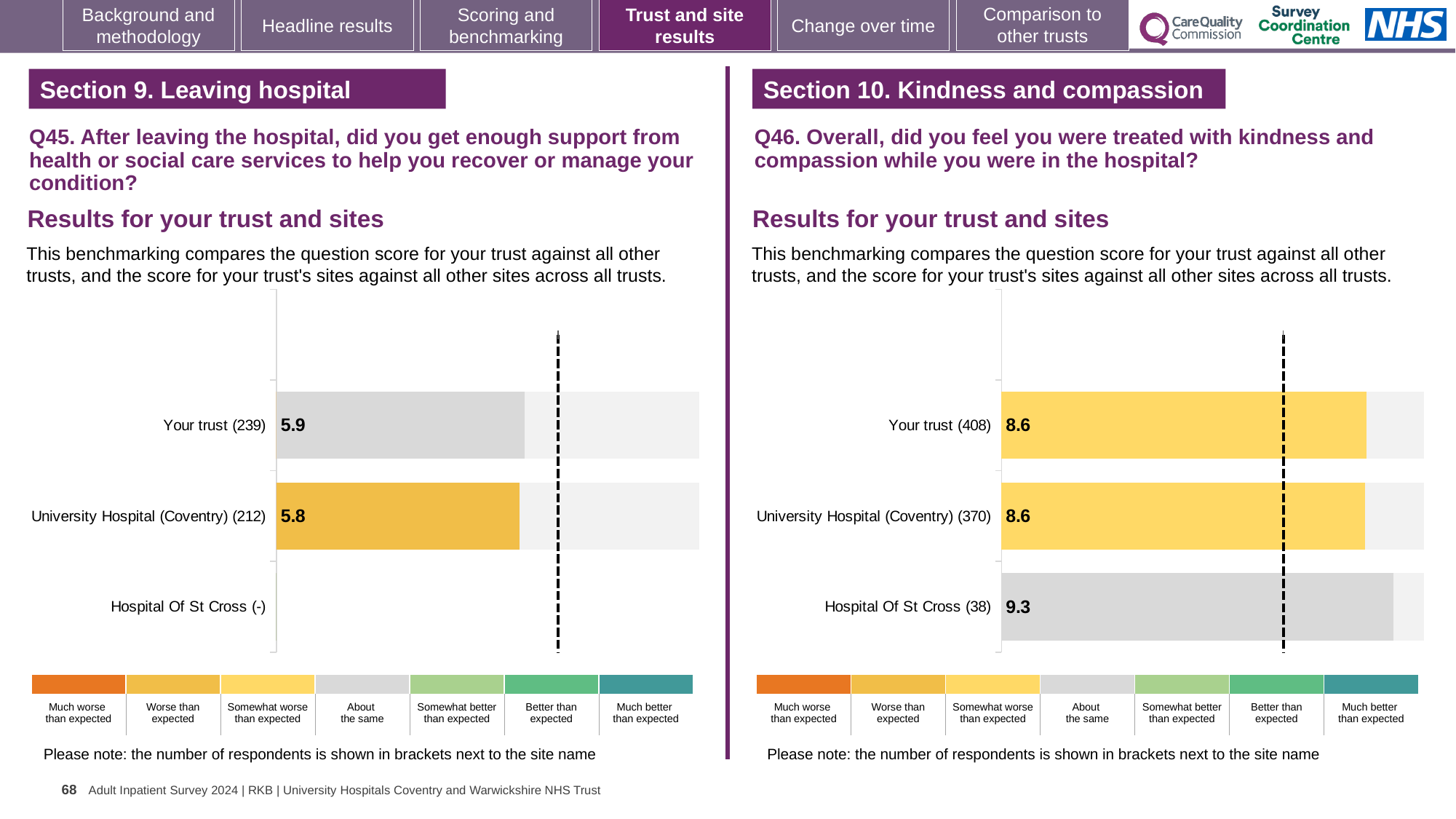
What kind of chart is used on the Q45 chart (left)? bar chart On the Q45 chart (left), how many respondents are shown in brackets for Your trust? 239 On the Q46 chart (right), what is the score for Hospital Of St Cross? 9.3 On the Q46 chart (right), which site or trust has the highest score? Hospital Of St Cross On the Q45 chart (left), what is the difference between the score for Your trust and the score for University Hospital (Coventry)? 0.1 On the Q46 chart (right), what is the score for Your trust? 8.6 On the Q46 chart (right), is the score for University Hospital (Coventry) larger than, smaller than, or equal to the score for Your trust? equal On the Q45 chart (left), what is the score for University Hospital (Coventry)? 5.8 On the Q46 chart (right), how many respondents are shown in brackets for Hospital Of St Cross? 38 On the Q45 chart (left), what is the score for Your trust? 5.9 On the Q45 chart (left), which benchmark category does the colour of the University Hospital (Coventry) bar correspond to? Worse than expected On the Q46 chart (right), what is the difference between the score for Hospital Of St Cross and the score for Your trust? 0.7